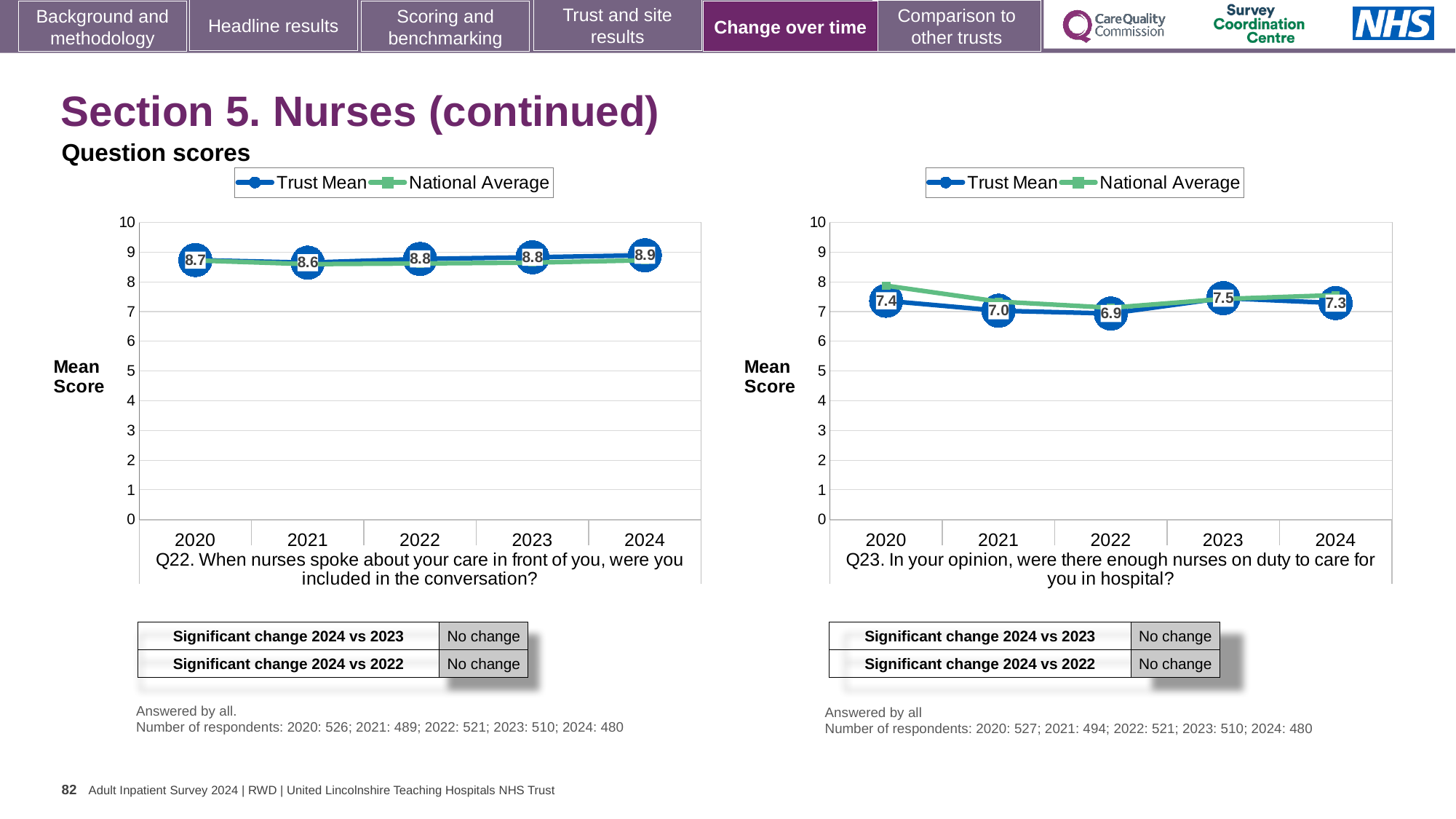
In the Q22 chart on the left, what is the Trust Mean score for 2024? 8.9 In the Q23 chart on the right, does the Trust Mean score rise or fall from 2020 to 2022? Fall How many years are plotted on the x axis of the Q22 chart on the left? 5 How many series does the legend of the Q23 chart on the right list? 2 What is the label of the y axis on the Q22 chart on the left? Mean Score In the Q23 chart on the right, what is the difference between the Trust Mean scores for 2023 and 2022? 0.6 In the Q23 chart on the right, which year has the highest Trust Mean score? 2023 In the Q23 chart on the right, is the National Average value for 2020 greater or less than 7? greater In the Q23 chart on the right, what is the Trust Mean score for 2022? 6.9 What kind of chart is the Q22 chart on the left? Line chart In the Q22 chart on the left, which year has the lowest Trust Mean score? 2021 In the Q22 chart on the left, is the Trust Mean score higher in 2020 or in 2021? 2020